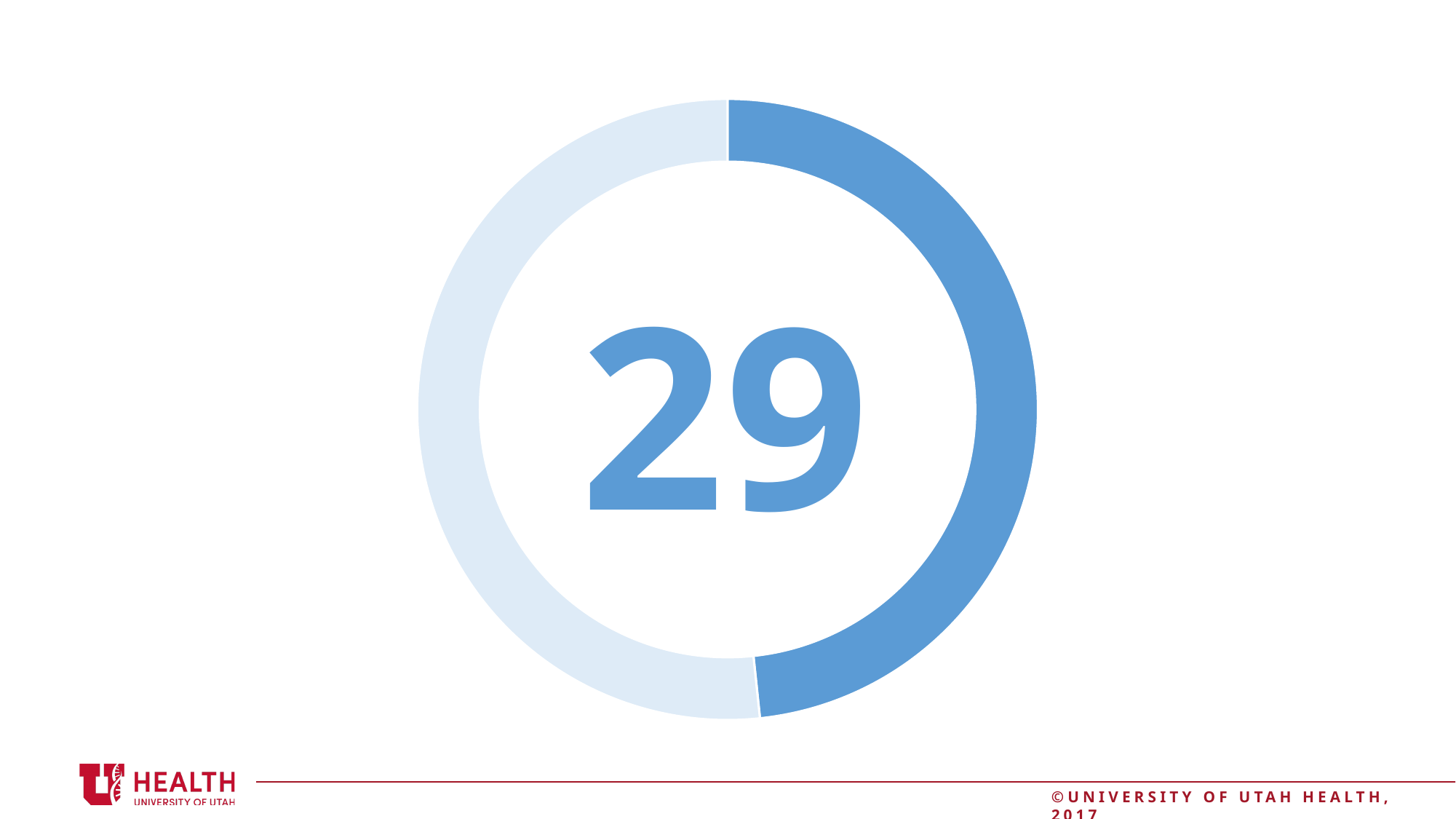
What number is displayed in the centre of the doughnut chart? 29 What colour is the filled (highlighted) segment of the doughnut chart? Dark blue What kind of chart is shown on the slide? Doughnut chart How many segments does the doughnut chart have? 2 Does the doughnut chart display a legend? No